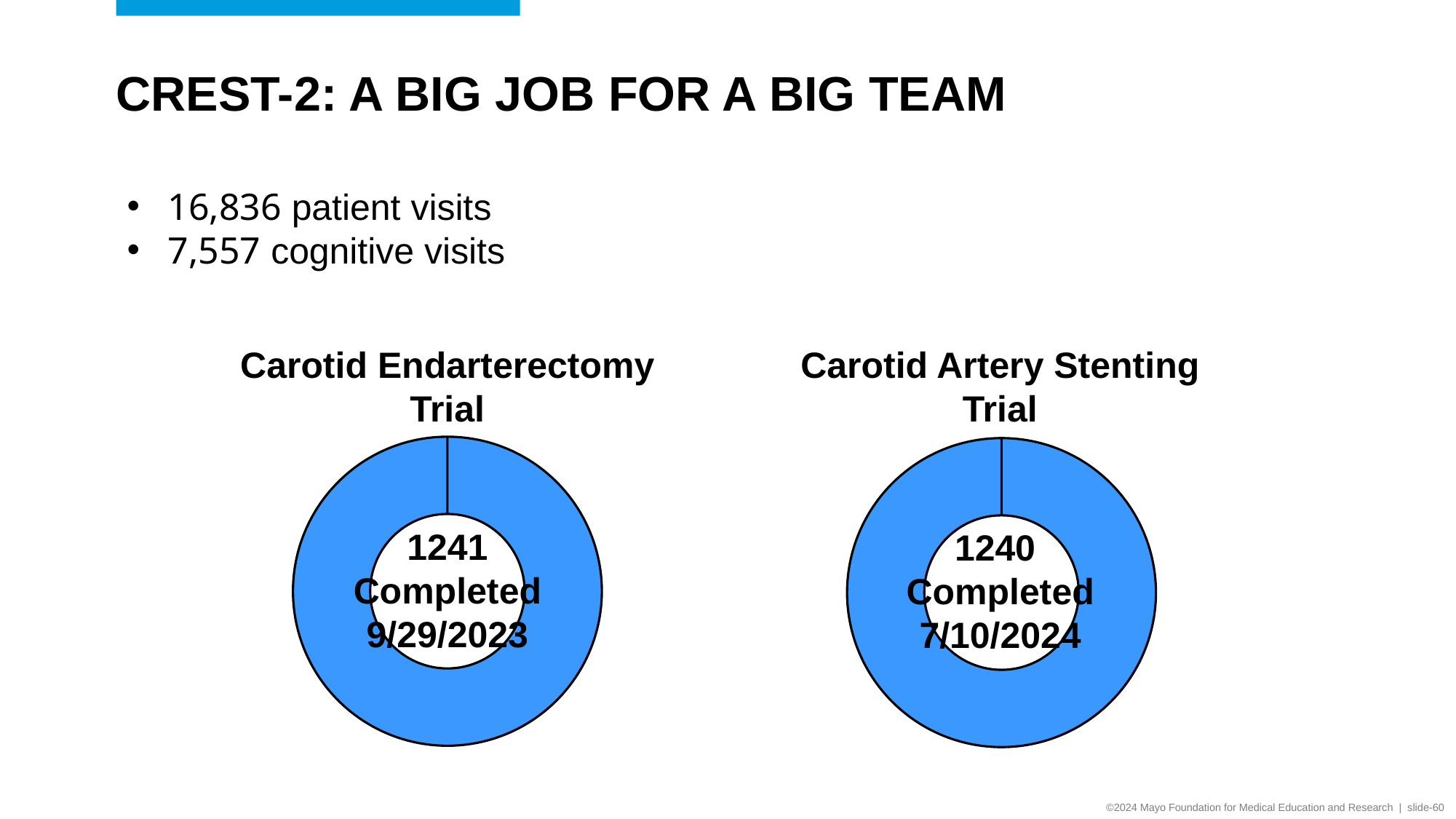
What is the difference between the completed number in the Carotid Endarterectomy Trial chart and the completed number in the Carotid Artery Stenting Trial chart? 1 What kind of chart is shown under the title "Carotid Endarterectomy Trial"? doughnut chart Which chart shows the larger completed number, the Carotid Endarterectomy Trial or the Carotid Artery Stenting Trial? Carotid Endarterectomy Trial What is the title of the chart on the right side of the slide? Carotid Artery Stenting Trial How many slices does the Carotid Endarterectomy Trial doughnut chart show? 1 In the Carotid Artery Stenting Trial chart, what number is printed in the centre of the doughnut? 1240 What colour is the ring of the Carotid Artery Stenting Trial doughnut chart? blue What kind of chart is shown under the title "Carotid Artery Stenting Trial"? doughnut chart In the Carotid Endarterectomy Trial chart, what completion date is printed in the centre? 9/29/2023 In the Carotid Artery Stenting Trial chart, what completion date is printed in the centre? 7/10/2024 How many doughnut charts are on the slide? 2 In the Carotid Endarterectomy Trial chart, what number is printed in the centre of the doughnut? 1241